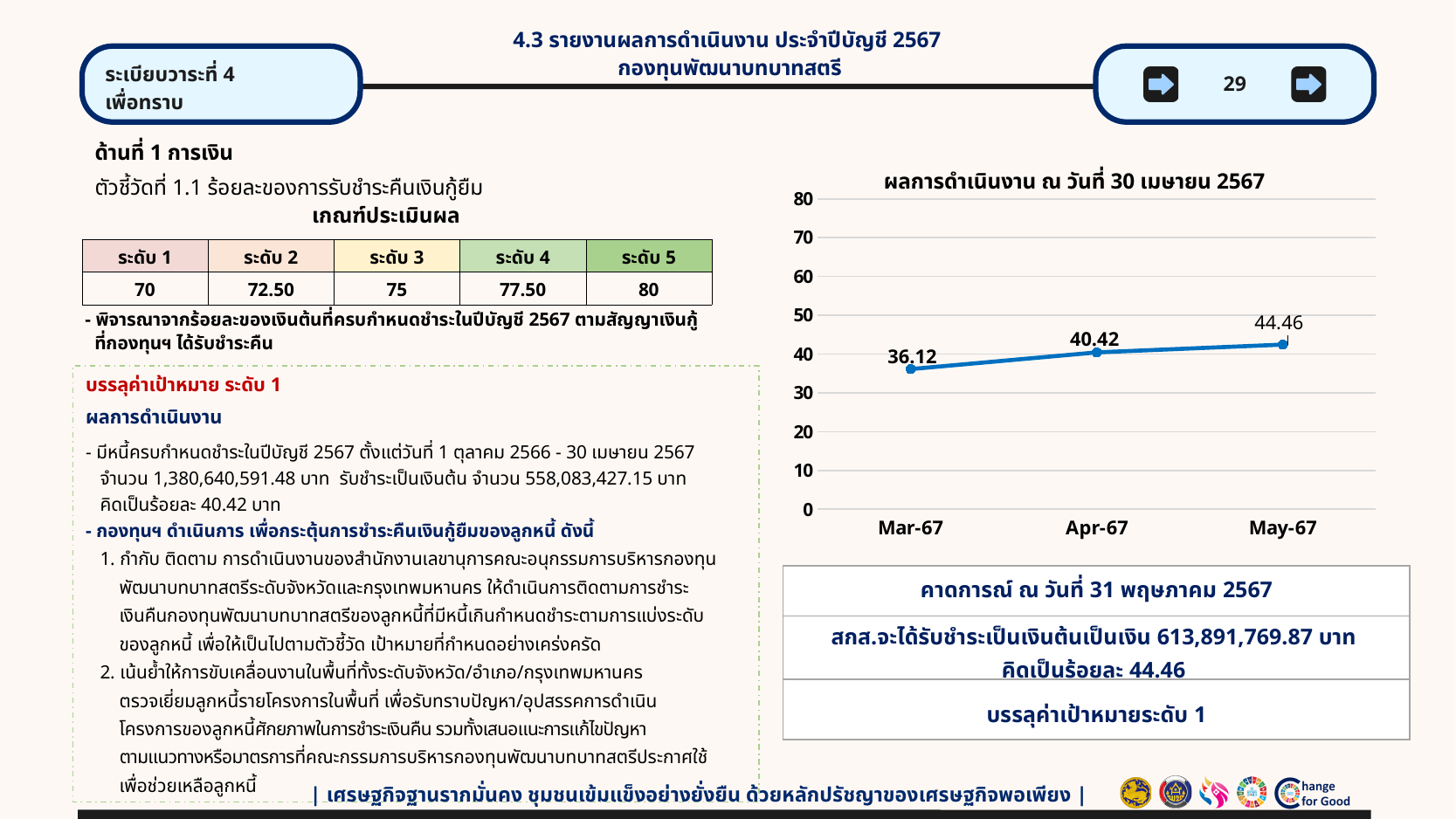
Is the value for May-67 greater or less than 40? greater What is the difference between the values for May-67 and Mar-67? 8.34 Which month has the highest value in the chart? May-67 Which is larger, the value for Apr-67 or the value for Mar-67? Apr-67 What is the value for May-67 in the chart? 44.46 What is the difference between the values for Apr-67 and Mar-67? 4.30 What is the value for Mar-67 in the chart? 36.12 Do the values rise or fall from Mar-67 to May-67? rise What kind of chart is shown on the slide? line chart How many data points are plotted in the chart? 3 What is the value for Apr-67 in the chart? 40.42 Which month has the lowest value in the chart? Mar-67